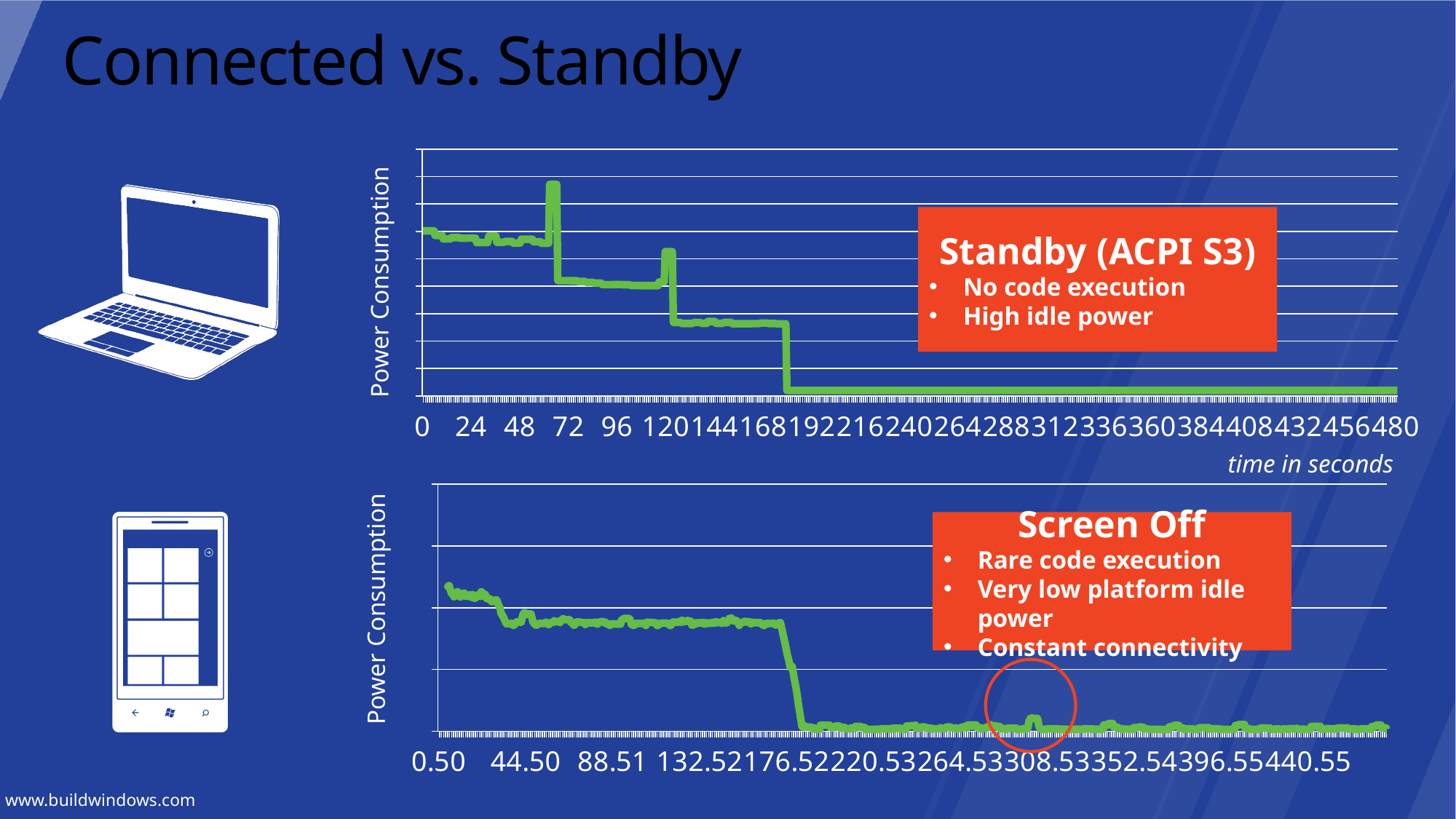
In the top chart, does power consumption rise or fall overall as time increases along the x axis? fall What unit label is printed below the x axis of the top chart? time in seconds What is the first tick value on the x axis of the bottom chart? 0.50 What is the last tick value on the x axis of the bottom chart? 440.55 What is the last tick value on the x axis of the top chart? 480 In the bottom chart, does power consumption rise or fall overall as time increases along the x axis? fall In the bottom chart, is power consumption higher at 88.51 seconds or at 352.54 seconds? 88.51 seconds What kind of chart is the bottom chart on the slide? line chart What kind of chart is the top chart on the slide? line chart What is the label on the vertical axis of the top chart? Power Consumption How many charts are shown on the slide? 2 In the top chart, is power consumption higher at 24 seconds or at 240 seconds? 24 seconds